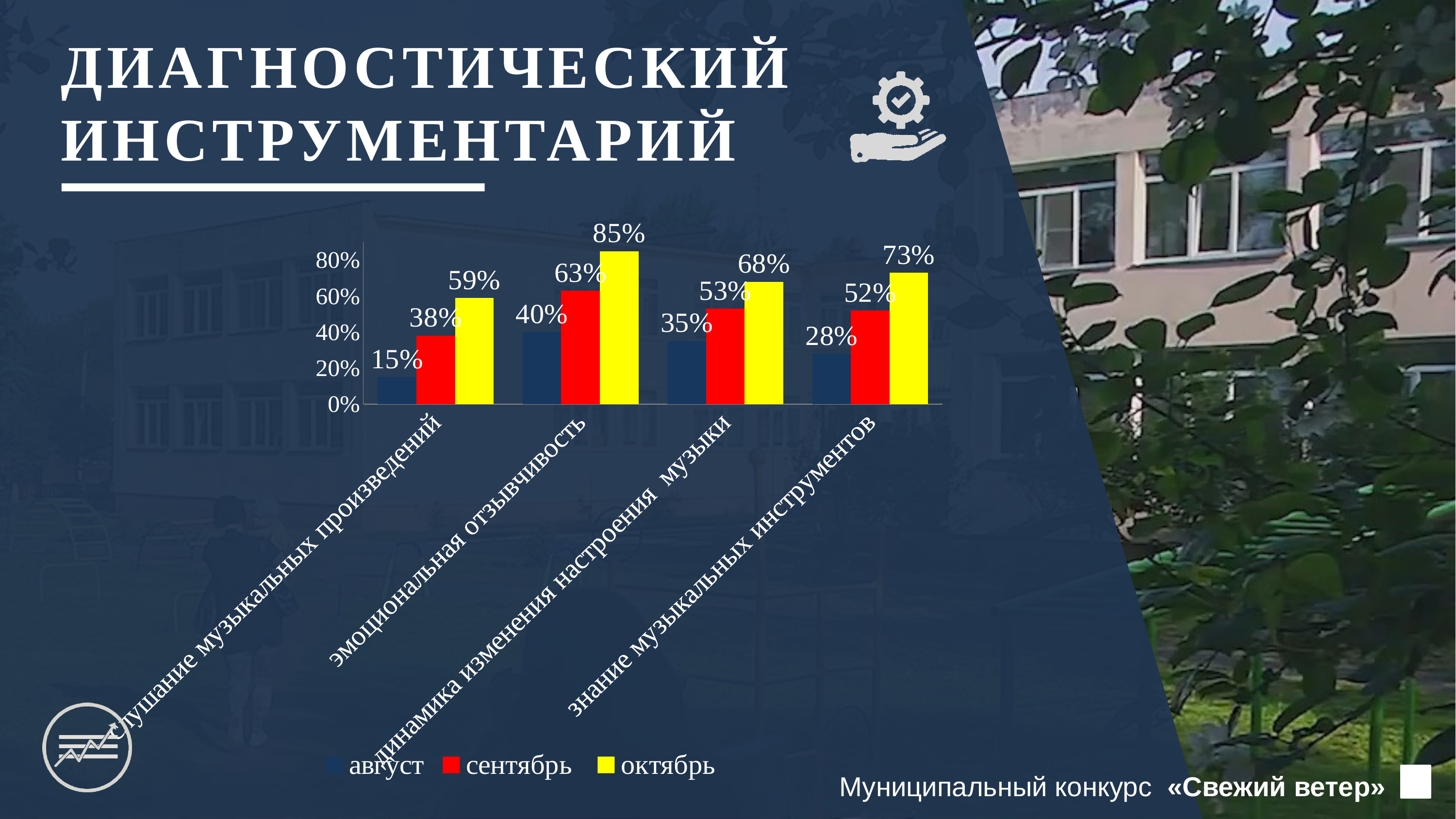
What is the value for сентябрь in the category знание музыкальных инструментов? 52% What is the value for октябрь in the category эмоциональная отзывчивость? 85% Which colour represents the series октябрь in the chart? yellow Which is larger: the сентябрь value for эмоциональная отзывчивость or the сентябрь value for динамика изменения настроения музыки? эмоциональная отзывчивость How many categories are shown on the x axis of the chart? 4 What kind of chart is shown on the slide? bar chart Which category has the lowest value for август? слушание музыкальных произведений What is the difference between the октябрь and август values for знание музыкальных инструментов? 45% What is the value for август in the category слушание музыкальных произведений? 15% Within each category, do the values rise or fall from август to октябрь? rise Which category has the highest value for октябрь? эмоциональная отзывчивость How many series does the chart legend list? 3